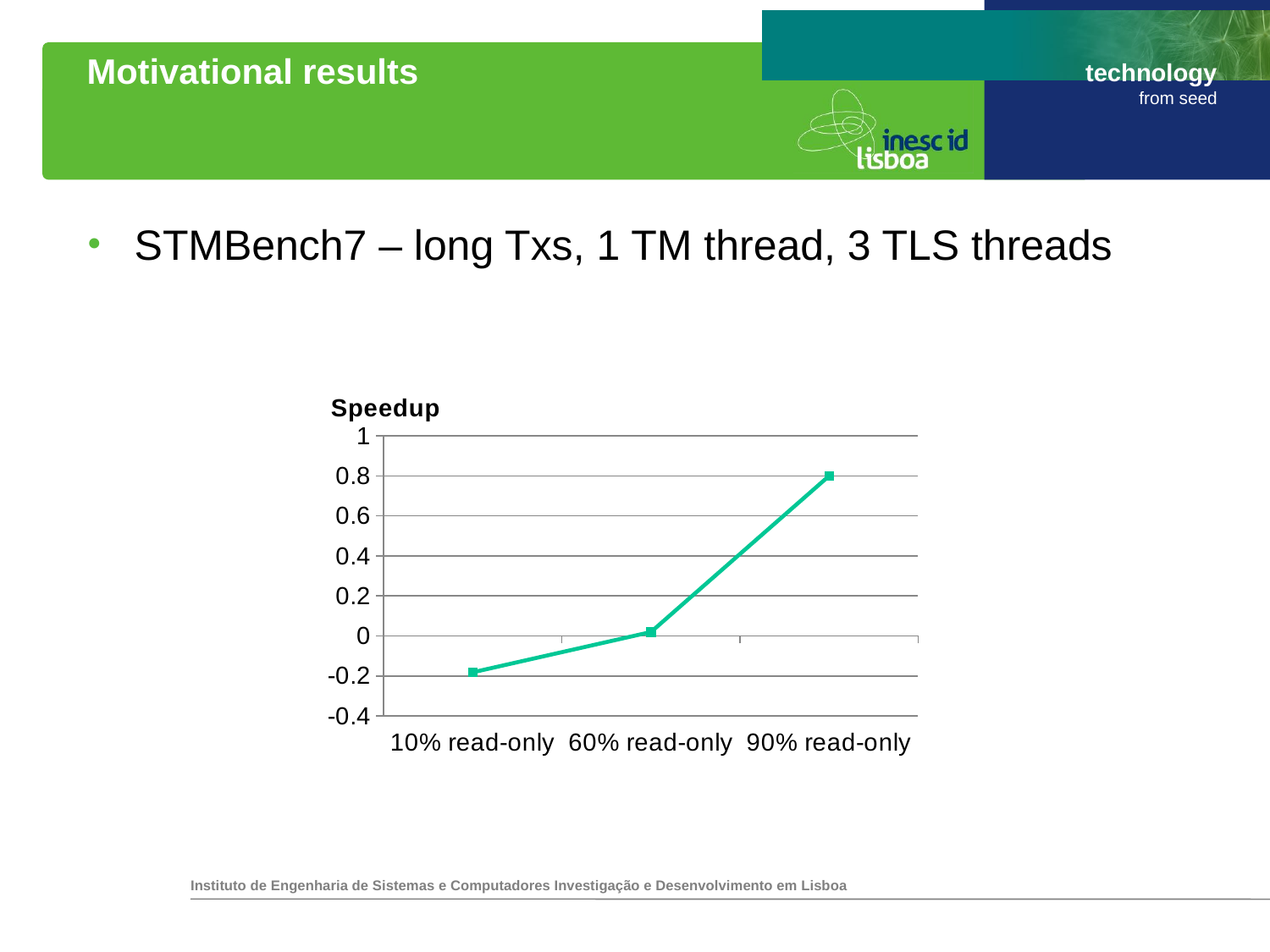
What are the category labels on the x axis? 10% read-only, 60% read-only, 90% read-only Does the speedup rise or fall as the read-only percentage increases along the x axis? rise Which has a larger speedup, 60% read-only or 90% read-only? 90% read-only Which category has the lowest speedup? 10% read-only Is the speedup for 10% read-only greater or less than 0? less What is the title of the chart? Speedup What is the speedup for 90% read-only? 0.8 Which category has the highest speedup? 90% read-only What kind of chart is shown on the slide? line chart Is the speedup for 10% read-only greater or less than -0.4? greater How many data points are plotted on the chart? 3 Is the speedup for 90% read-only greater or less than 0.6? greater